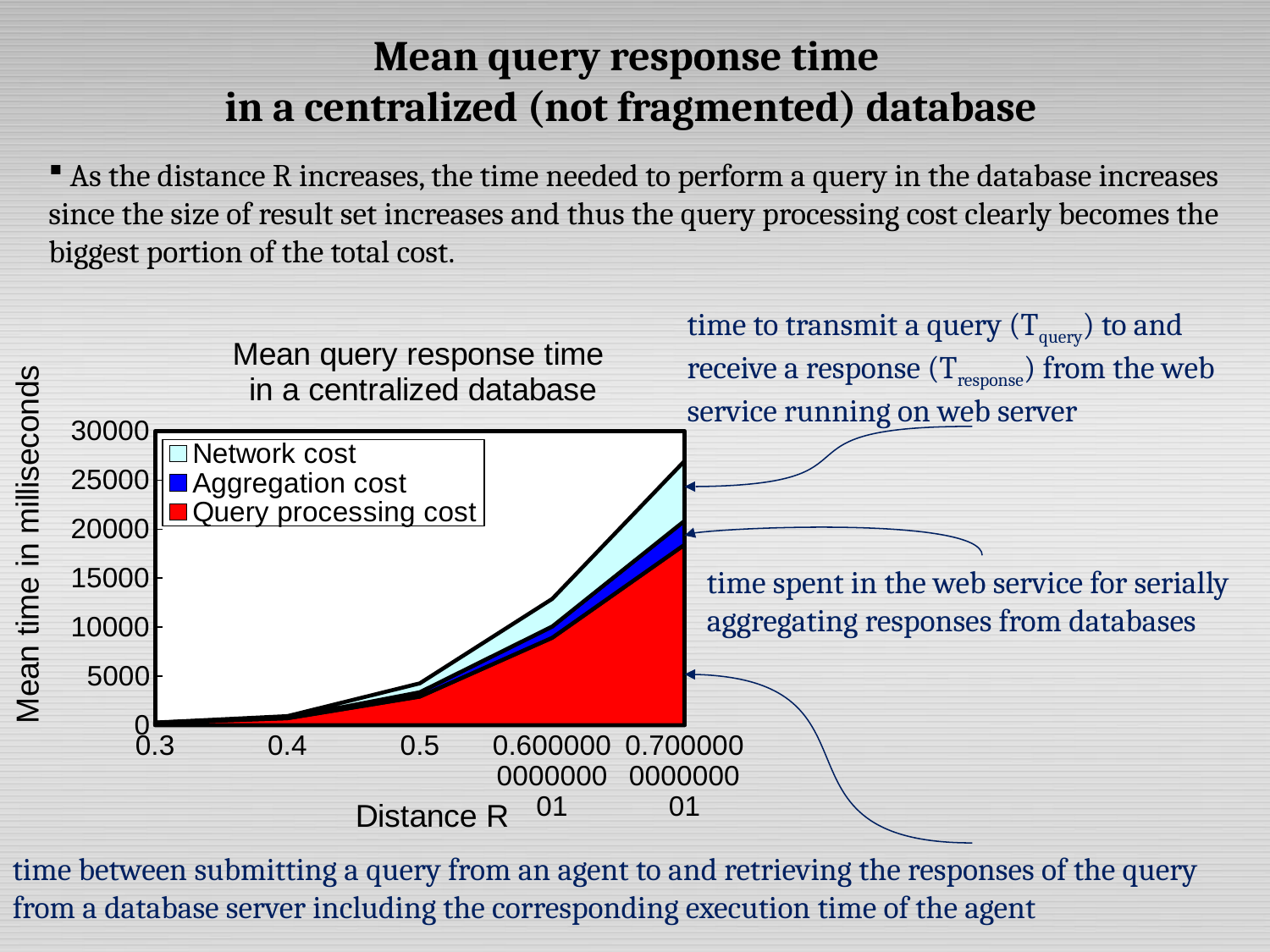
Which cost component makes up the largest portion of the total at Distance R = 0.7? Query processing cost Is the total mean query response time at Distance R = 0.6 greater or less than 10000? greater At which Distance R value is the total mean query response time lowest? 0.3 How many series does the chart's legend list? 3 At which Distance R value is the total mean query response time highest? 0.7 Is the query processing cost at Distance R = 0.7 greater or less than 15000? greater How many distance values are plotted along the x axis of the chart? 5 What kind of chart is shown on the slide? Stacked area chart What is the label of the chart's y axis? Mean time in milliseconds Does the total mean query response time rise or fall as Distance R increases? Rises Is the total mean query response time at Distance R = 0.5 greater or less than 5000? less